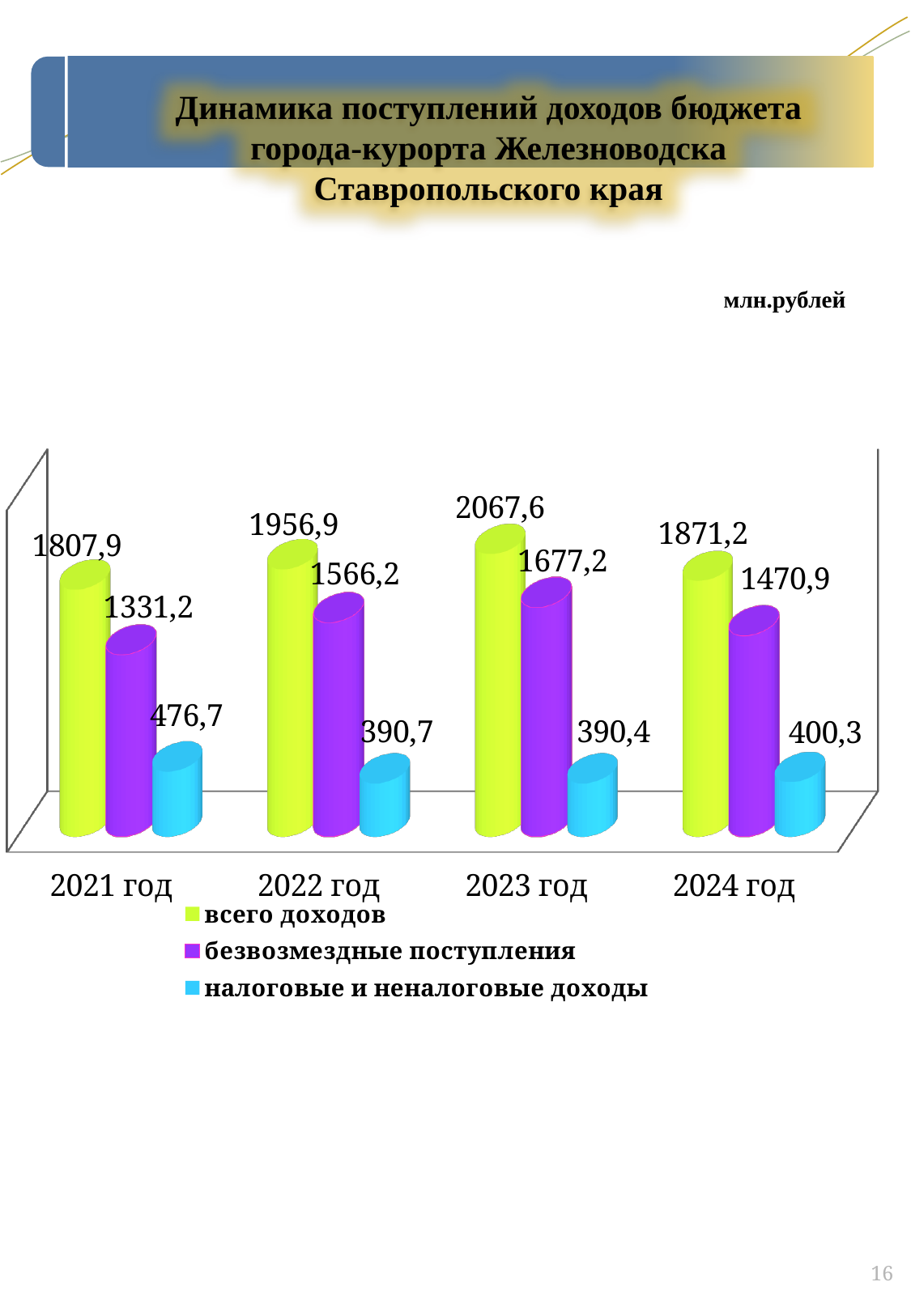
How many series does the legend list? 3 In which year is всего доходов the highest? 2023 год How many years are shown on the x axis? 4 Which is larger: безвозмездные поступления in 2022 год or in 2024 год? 2022 год What is the difference between всего доходов in 2023 год and in 2024 год? 196,4 What kind of chart is shown on the slide? bar chart What is the value for безвозмездные поступления in 2021 год? 1331,2 What is the value for всего доходов in 2023 год? 2067,6 What is the value for налоговые и неналоговые доходы in 2024 год? 400,3 In which year is налоговые и неналоговые доходы the lowest? 2023 год What is the difference between налоговые и неналоговые доходы in 2021 год and in 2024 год? 76,4 Does всего доходов rise or fall from 2021 год to 2023 год? rise